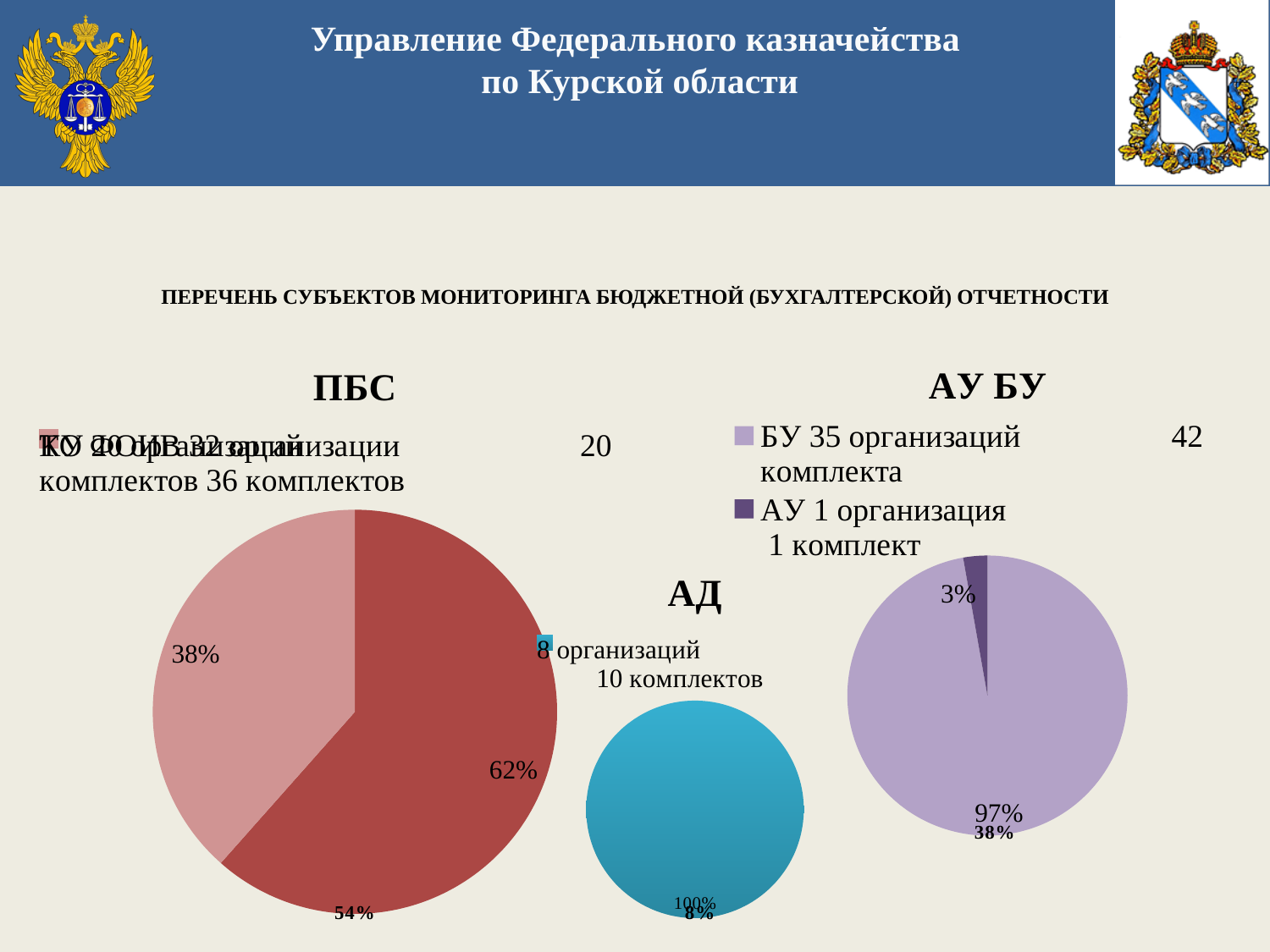
What kind of chart is the ПБС chart? pie chart According to the legend of the АД chart, how many organisations does it cover? 8 организаций How many slices does the ПБС pie chart have? 2 In the ПБС pie chart, what is the share of the smaller slice? 38% In the АУ БУ pie chart, which slice is larger, БУ or АУ? БУ In the АУ БУ pie chart, what is the share of the АУ slice? 3% In the ПБС pie chart, what is the difference between the two slices' shares? 24% How many entries does the legend of the АУ БУ chart list? 2 In the АУ БУ pie chart, what is the share of the БУ slice? 97% How many pie charts are shown on the slide? 3